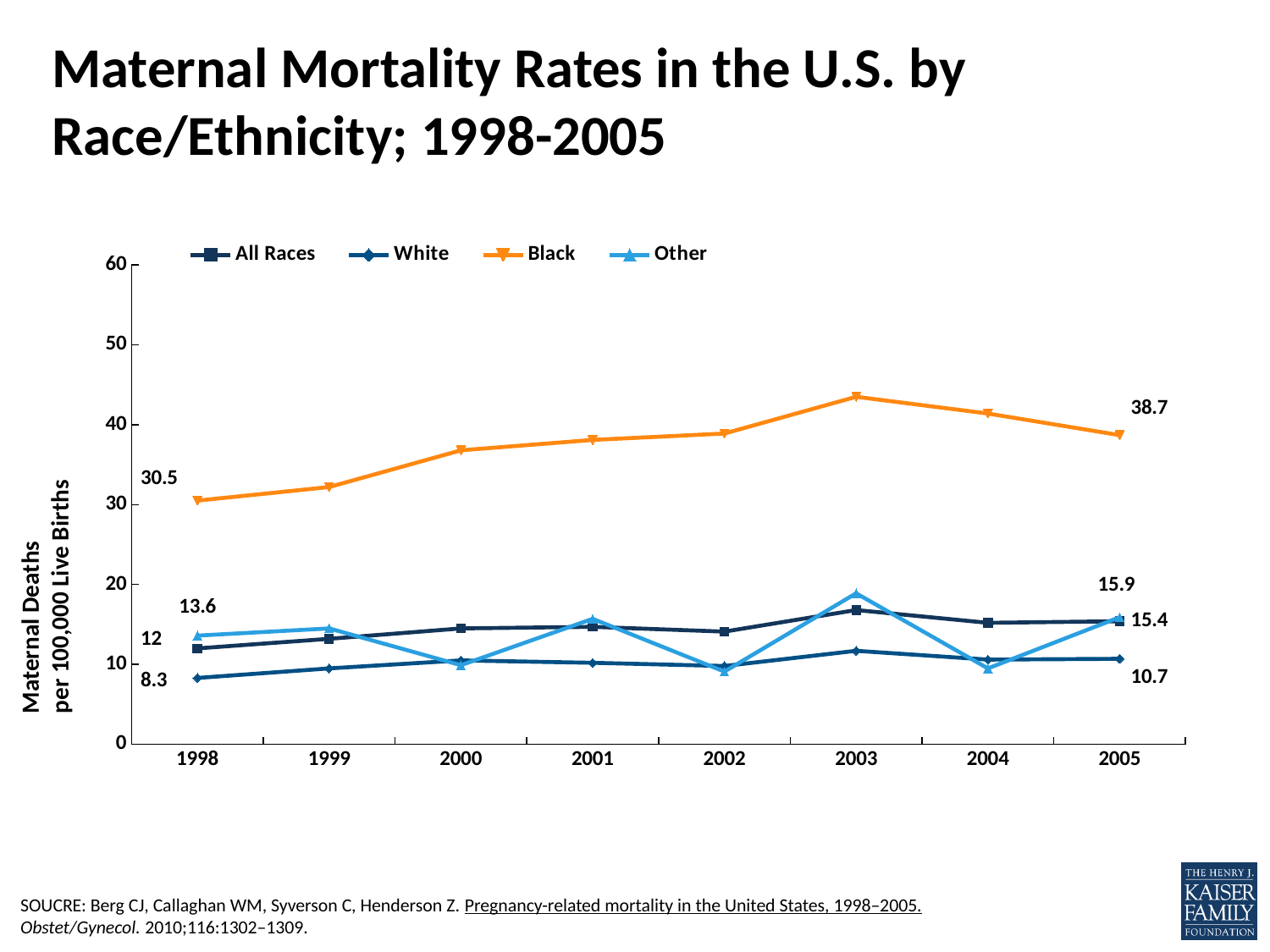
What is the maternal mortality rate for White women in 1998? 8.3 How many series does the legend list? 4 How many years are plotted along the x axis? 8 What is the maternal mortality rate for White women in 2005? 10.7 Which race/ethnicity group has the highest maternal mortality rate in 1998? Black What is the maternal mortality rate for Black women in 1998? 30.5 What type of chart is shown on the slide? line chart Is the value for Black women in 2003 greater or less than 40? greater What is the maternal mortality rate for All Races in 1998? 12 By how much did the maternal mortality rate for Black women increase from 1998 to 2005? 8.2 What is the maternal mortality rate for Black women in 2005? 38.7 Does the maternal mortality rate for Black women rise or fall from 1998 to 2003? rise